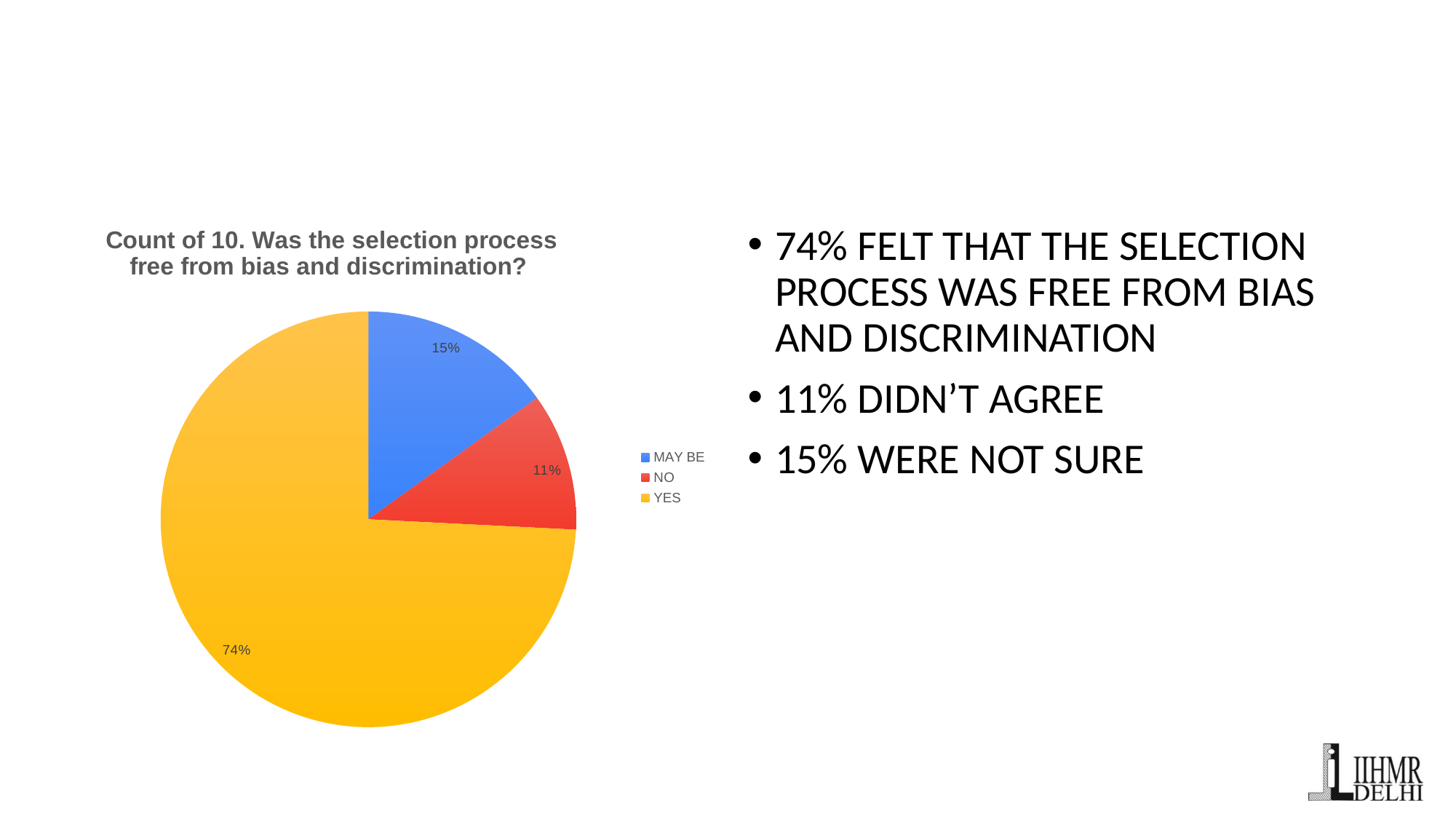
What is the difference in percentage points between the MAY BE and NO slices? 4 Which slice is larger, MAY BE or NO? MAY BE What share of the pie does the YES slice represent? 74% Which category has the largest slice of the pie? YES How many categories does the pie chart show? 3 What share of the pie does the MAY BE slice represent? 15% Which category has the smallest slice of the pie? NO What is the title of the chart? Count of 10. Was the selection process free from bias and discrimination? What colour is the YES slice in the pie chart? Yellow What is the difference in percentage points between the YES and NO slices? 63 What kind of chart is shown on the slide? Pie chart What share of the pie does the NO slice represent? 11%